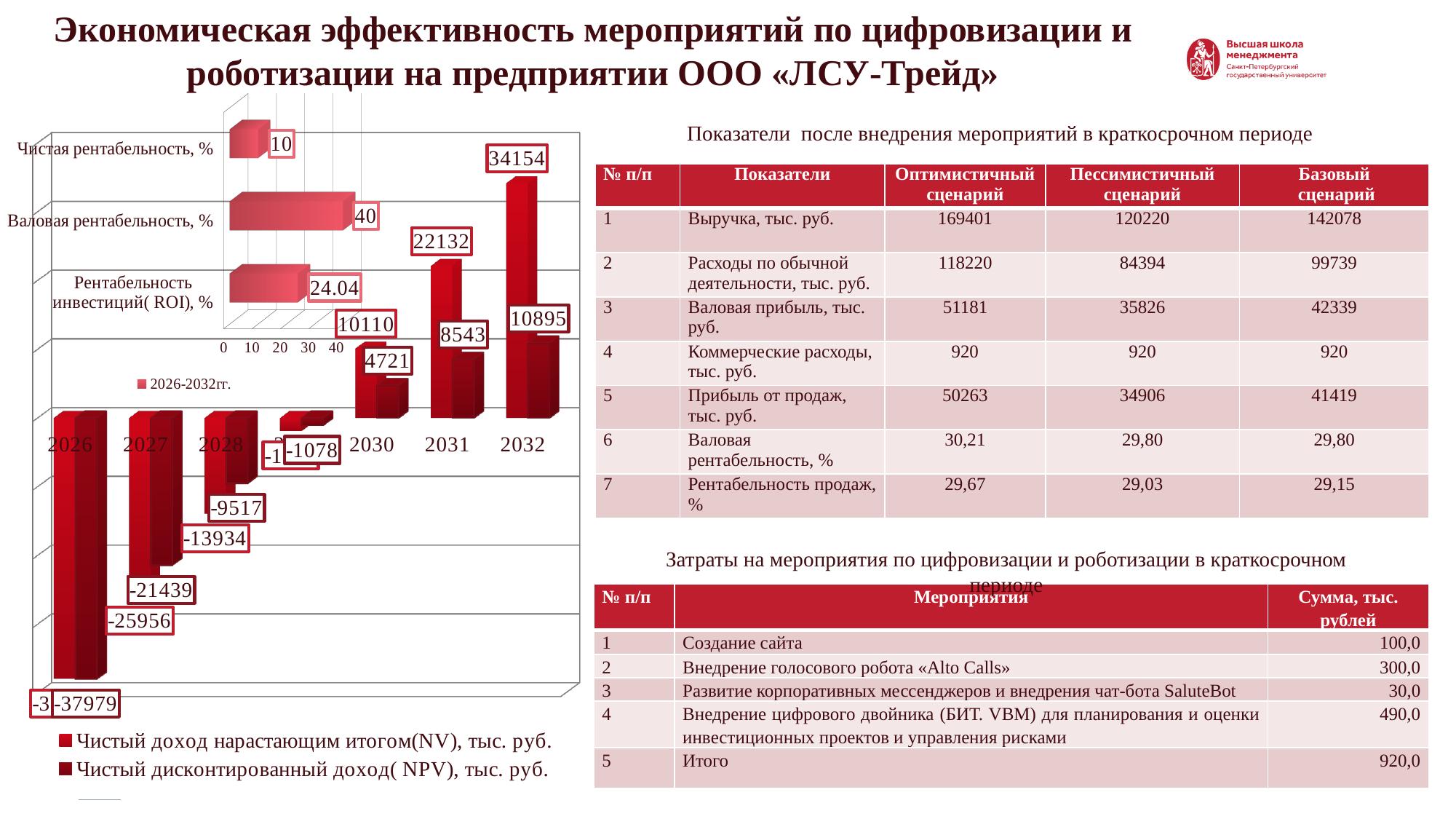
In the large chart of net income by year, do the values rise or fall from 2026 to 2032? rise In the large chart of net income by year, what is the difference between the NV and NPV values for 2032? 23259 In the small inset chart at the top left, what is the value for Валовая рентабельность, %? 40 In the large chart of net income by year, what is the value of Чистый дисконтированный доход (NPV) for 2031? 8543 In the small inset chart at the top left, which category has the lowest value? Чистая рентабельность, % In the small inset chart at the top left, how many categories are plotted? 3 In the large chart of net income by year, how many series does the legend list? 2 In the small inset chart at the top left, what is the difference between Валовая рентабельность and Чистая рентабельность? 30 In the small inset chart at the top left, what is the value for Рентабельность инвестиций (ROI), %? 24.04 In the large chart of net income by year, how many years are shown on the x axis? 7 In the small inset chart at the top left, which category has the highest value? Валовая рентабельность, % In the large chart of net income by year, what is the value of Чистый доход нарастающим итогом (NV) for 2032? 34154